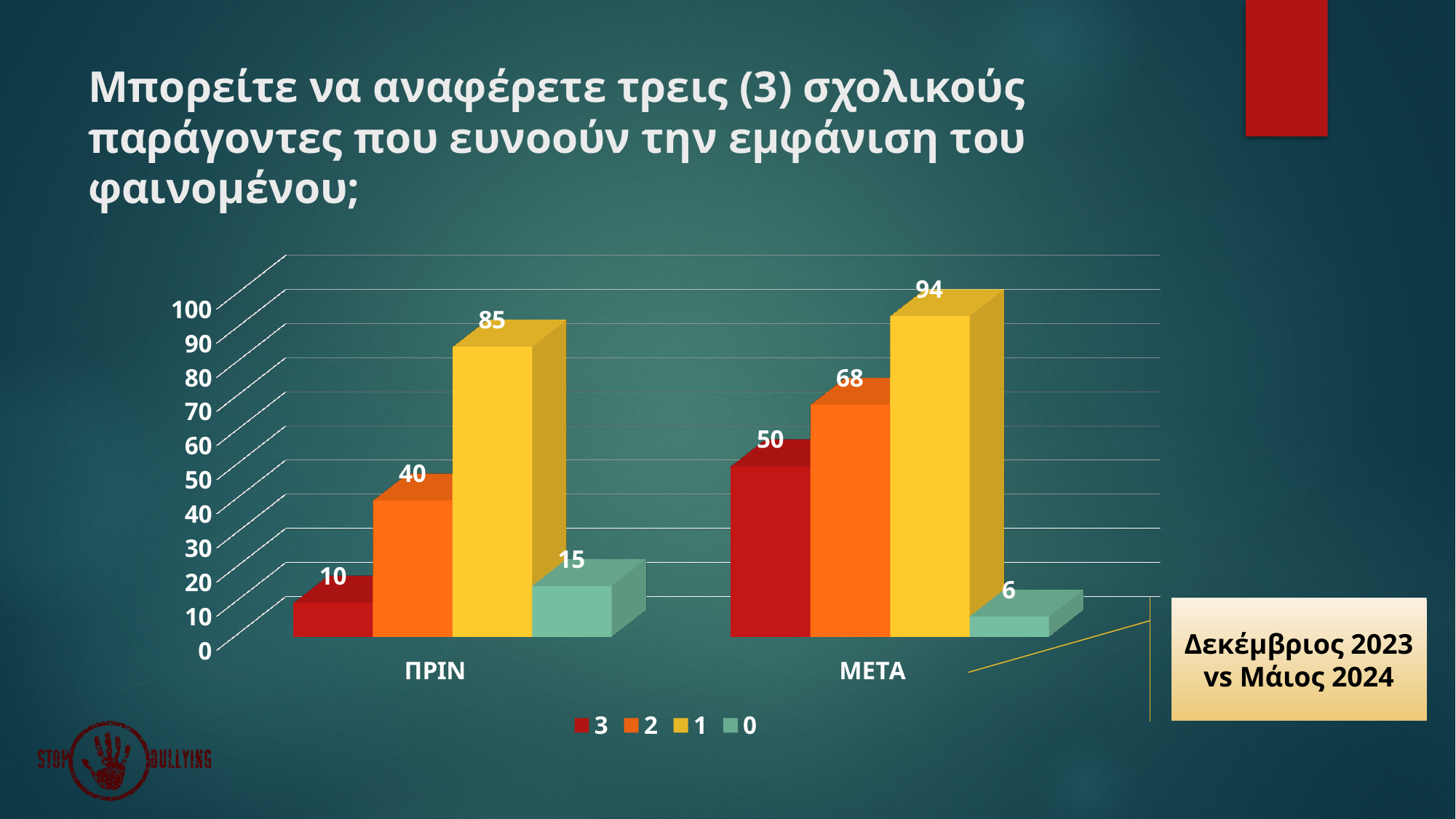
How many categories are shown on the x axis? 2 What is the value for series 1 in the ΠΡΙΝ category? 85 What is the difference between the value for series 1 in ΜΕΤΑ and the value for series 1 in ΠΡΙΝ? 9 Which is larger: the value for series 2 in ΠΡΙΝ or the value for series 2 in ΜΕΤΑ? ΜΕΤΑ Which series has the highest value in the ΜΕΤΑ category? 1 What text appears in the callout box to the right of the chart? Δεκέμβριος 2023 vs Μάιος 2024 What kind of chart is shown on the slide? Bar chart What is the value for series 2 in the ΠΡΙΝ category? 40 Which series has the lowest value in the ΠΡΙΝ category? 3 What is the value for series 0 in the ΜΕΤΑ category? 6 How many series does the legend list? 4 What is the value for series 3 in the ΜΕΤΑ category? 50